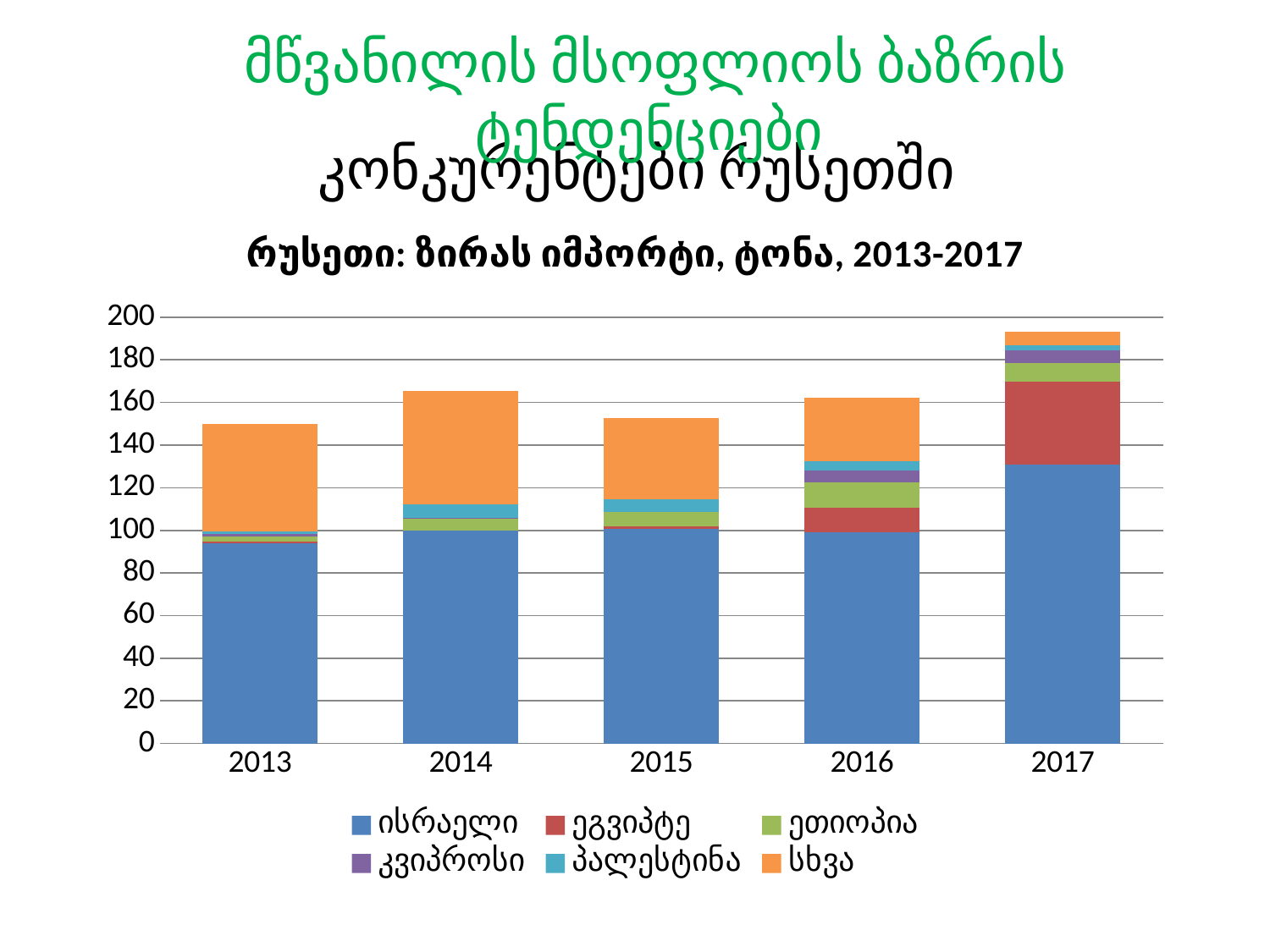
How many years are shown on the x axis of the chart? 5 Is the total for 2017 greater or less than 180? greater Which series is shown in orange in the chart legend? სხვა How many series does the chart legend list? 6 Is the value for ისრაელი in 2017 greater or less than 120? greater Does the ისრაელი segment rise or fall from 2016 to 2017? rise Which year has the larger ისრაელი segment, 2016 or 2017? 2017 What kind of chart is shown on the slide? Stacked bar chart Which year has the larger total bar, 2013 or 2017? 2017 Which year has the highest total stacked bar? 2017 Is the value for ისრაელი in 2013 greater or less than 80? greater